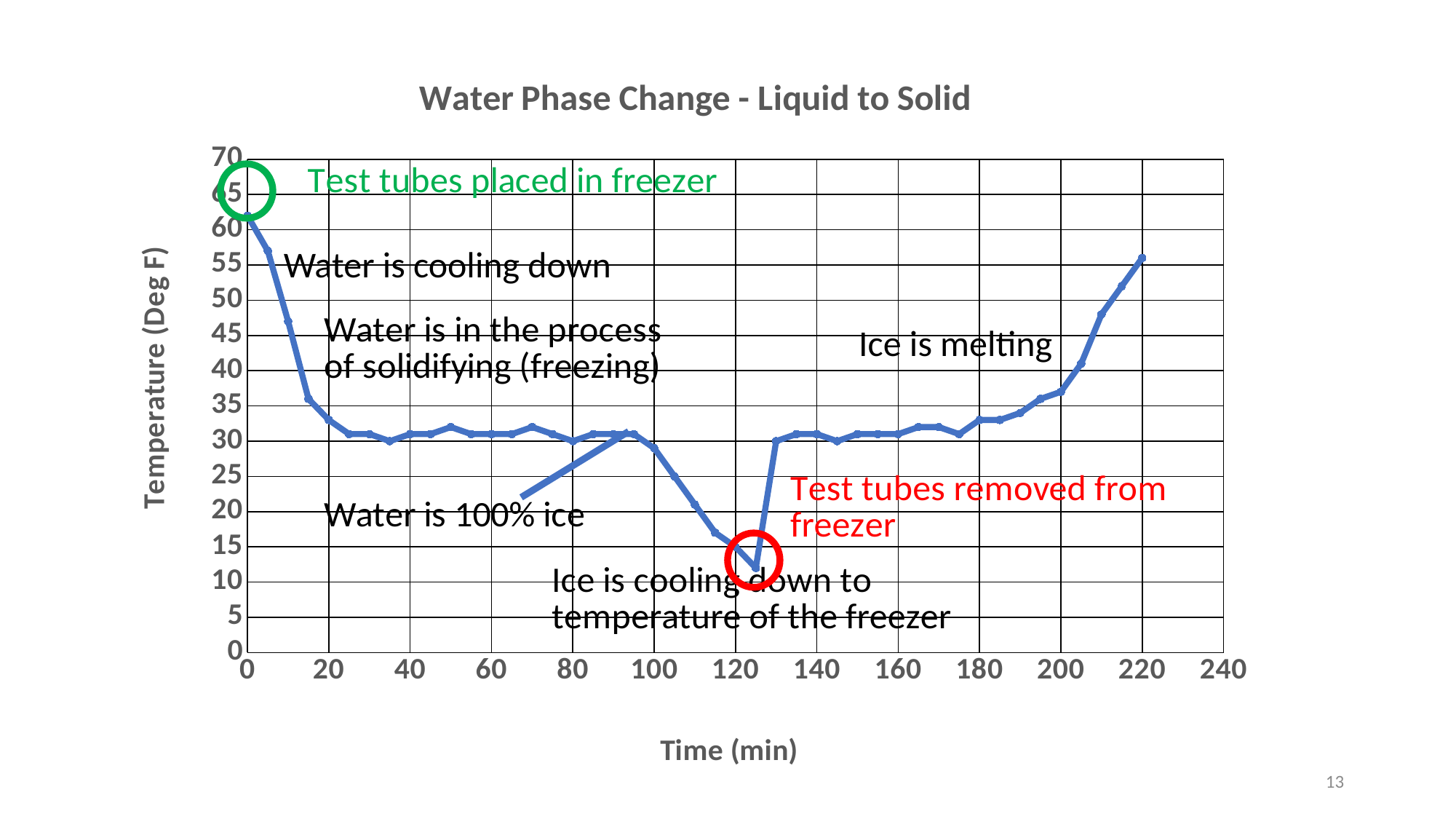
Is the temperature at 220 minutes greater or less than 50? greater What is the title of the chart? Water Phase Change - Liquid to Solid What is the label of the vertical axis? Temperature (Deg F) At what time does the temperature reach its lowest value? 125 min Is the temperature at 0 minutes greater or less than 55? greater Does the temperature rise or fall between 0 and 20 minutes? fall At what time is the temperature at its highest? 0 min Is the temperature at 15 minutes greater or less than 30? greater What kind of chart is shown on the slide? line chart Does the temperature rise or fall between 200 and 220 minutes? rise